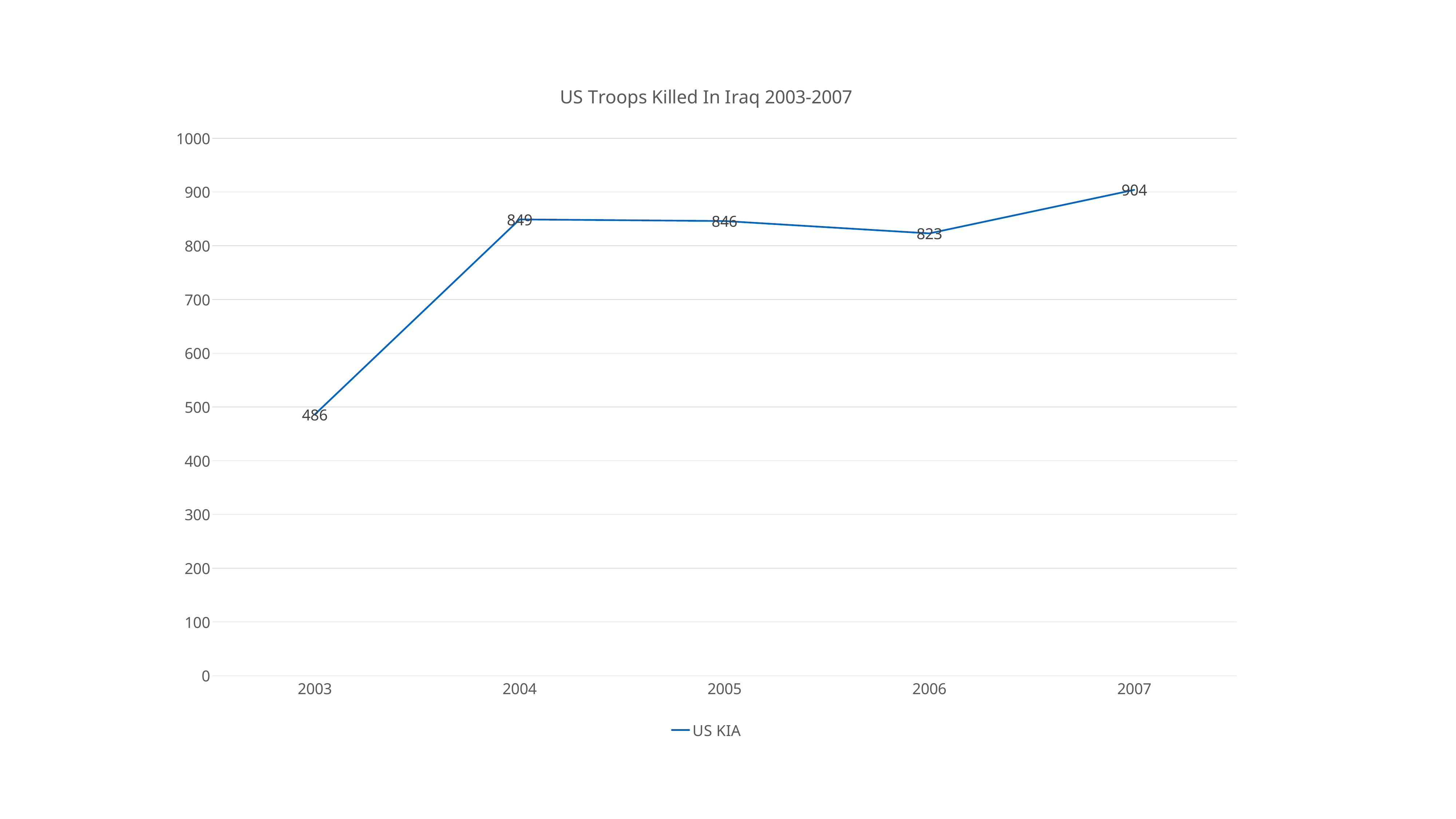
Which year has the highest value? 2007 Which year has the lowest value? 2003 Is the value for 2003 greater or less than 500? less What kind of chart is shown? line chart What is the value for 2007? 904 How many years are plotted on the x axis? 5 What is the title of the chart? US Troops Killed In Iraq 2003-2007 What is the difference between the values for 2007 and 2006? 81 What is the value for 2005? 846 What is the value for 2003? 486 What is the difference between the values for 2004 and 2003? 363 Which is larger, the value for 2006 or the value for 2007? 2007